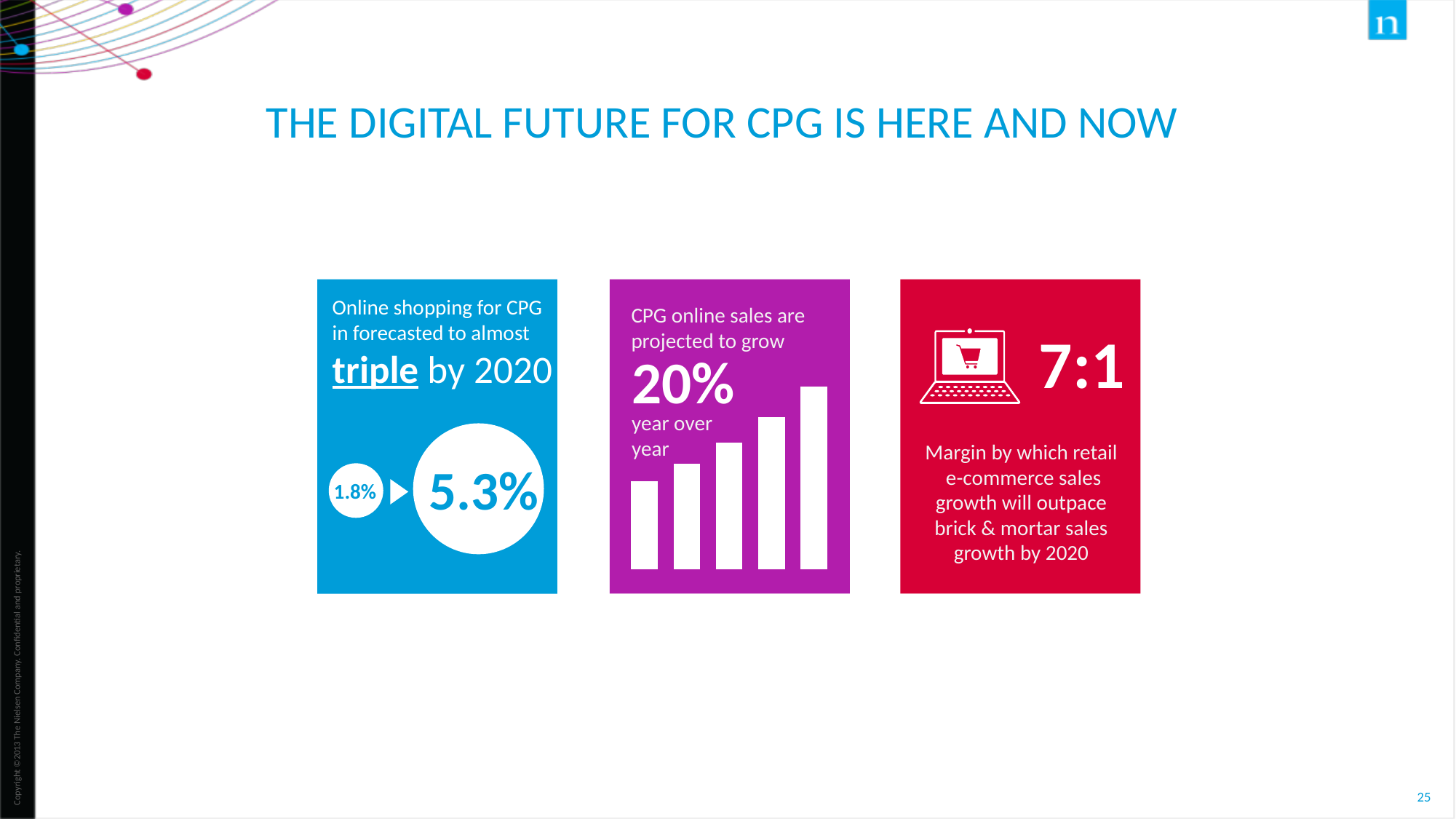
What kind of chart is shown in the purple panel? bar chart In the purple panel's bar graphic, how many bars are shown? 5 In the purple panel's bar graphic, do the bars rise or fall from left to right? rise In the purple panel's bar graphic, which bar is the tallest, the leftmost or the rightmost? rightmost In the purple panel's bar graphic, which bar is the shortest, the leftmost or the rightmost? leftmost What colour are the bars in the purple panel's bar graphic? white What growth rate is printed above the bar graphic in the purple panel? 20%